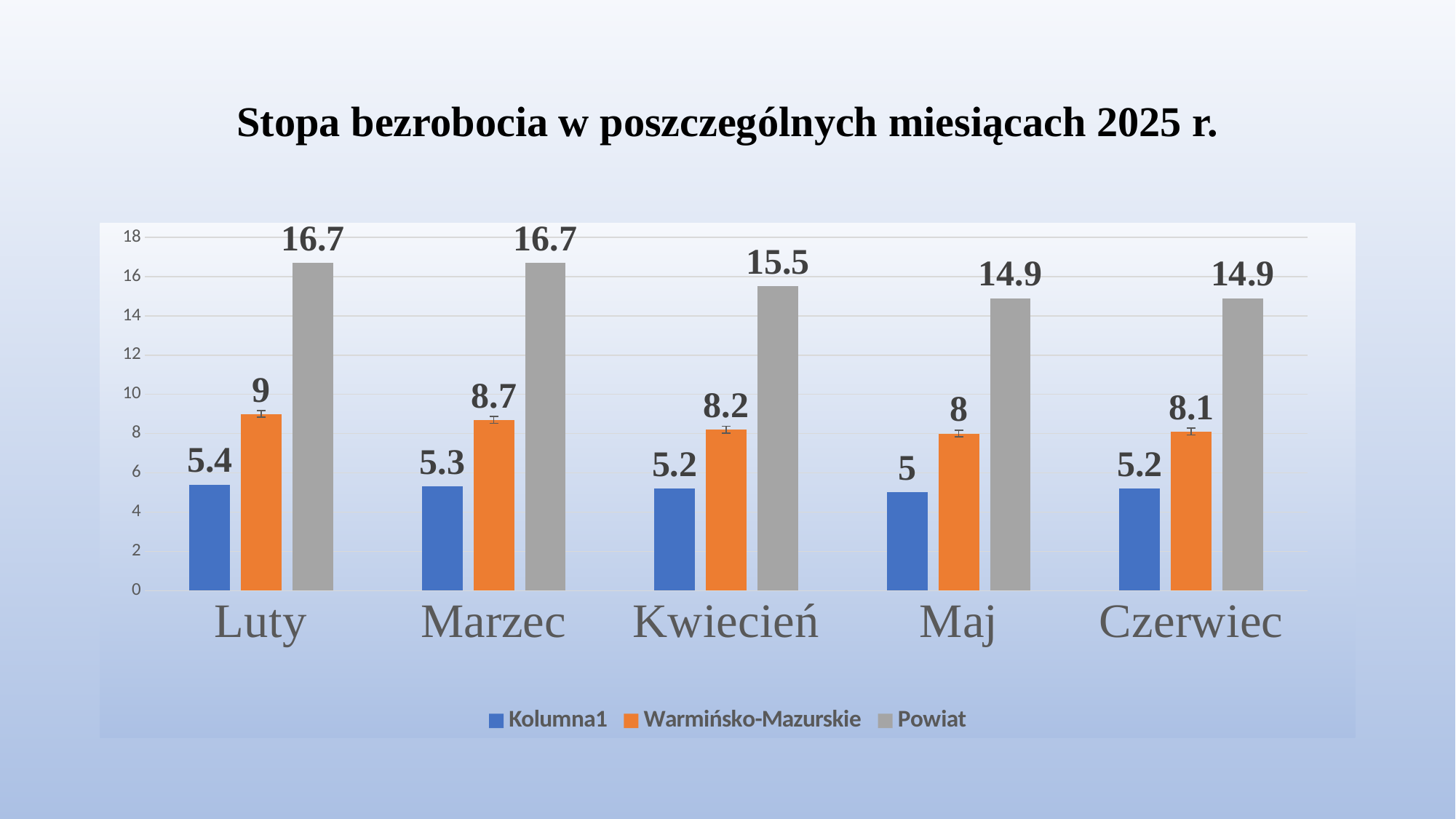
What is the value for Kolumna1 in Maj? 5 How many months are shown on the x axis? 5 What is the value for Powiat in Luty? 16.7 What is the value for Warmińsko-Mazurskie in Kwiecień? 8.2 What is the difference between the Powiat value and the Warmińsko-Mazurskie value in Marzec? 8 Is the Powiat value for Kwiecień greater or less than 14? greater How many series does the legend list? 3 What kind of chart is shown on the slide? bar chart In which month is the Powiat value lowest? Maj and Czerwiec Do the Powiat values rise or fall from Luty to Czerwiec? fall In which month is the Warmińsko-Mazurskie value highest? Luty Which is larger in Czerwiec: the Warmińsko-Mazurskie value or the Kolumna1 value? Warmińsko-Mazurskie